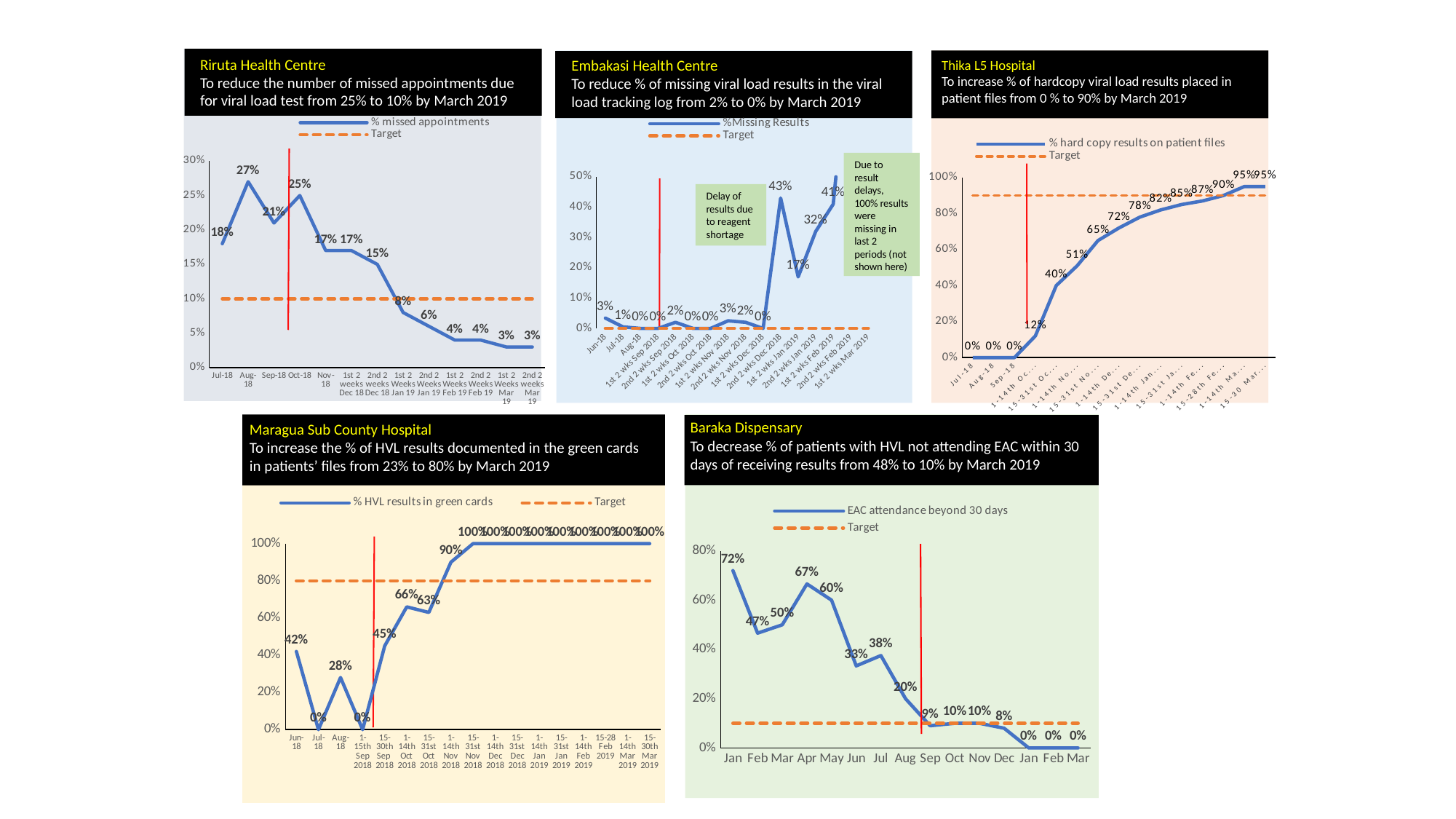
In the Riruta Health Centre chart, what is the % missed appointments value for Aug-18? 27% In the Baraka Dispensary chart, what is the EAC attendance beyond 30 days value for Apr? 67% In the Maragua Sub County Hospital chart, which is larger: the value for 1-14th Oct 2018 or the value for 15-31st Oct 2018? 1-14th Oct 2018 In the Thika L5 Hospital chart, what is the last plotted value for % hard copy results on patient files? 95% In the Embakasi Health Centre chart, what is the %Missing Results value for Jun-18? 3% In the Thika L5 Hospital chart, what kind of chart is shown? Line chart In the Baraka Dispensary chart, how many months are plotted on the x axis? 15 In the Embakasi Health Centre chart, what is the %Missing Results value for 2nd 2 wks Dec 2018? 43% In the Maragua Sub County Hospital chart, what is the % HVL results in green cards value for 1-14th Nov 2018? 90% In the Riruta Health Centre chart, which month has the highest % missed appointments? Aug-18 In the Baraka Dispensary chart, how many series does the legend list? 2 In the Riruta Health Centre chart, what is the difference between the Oct-18 value and the Nov-18 value? 8%